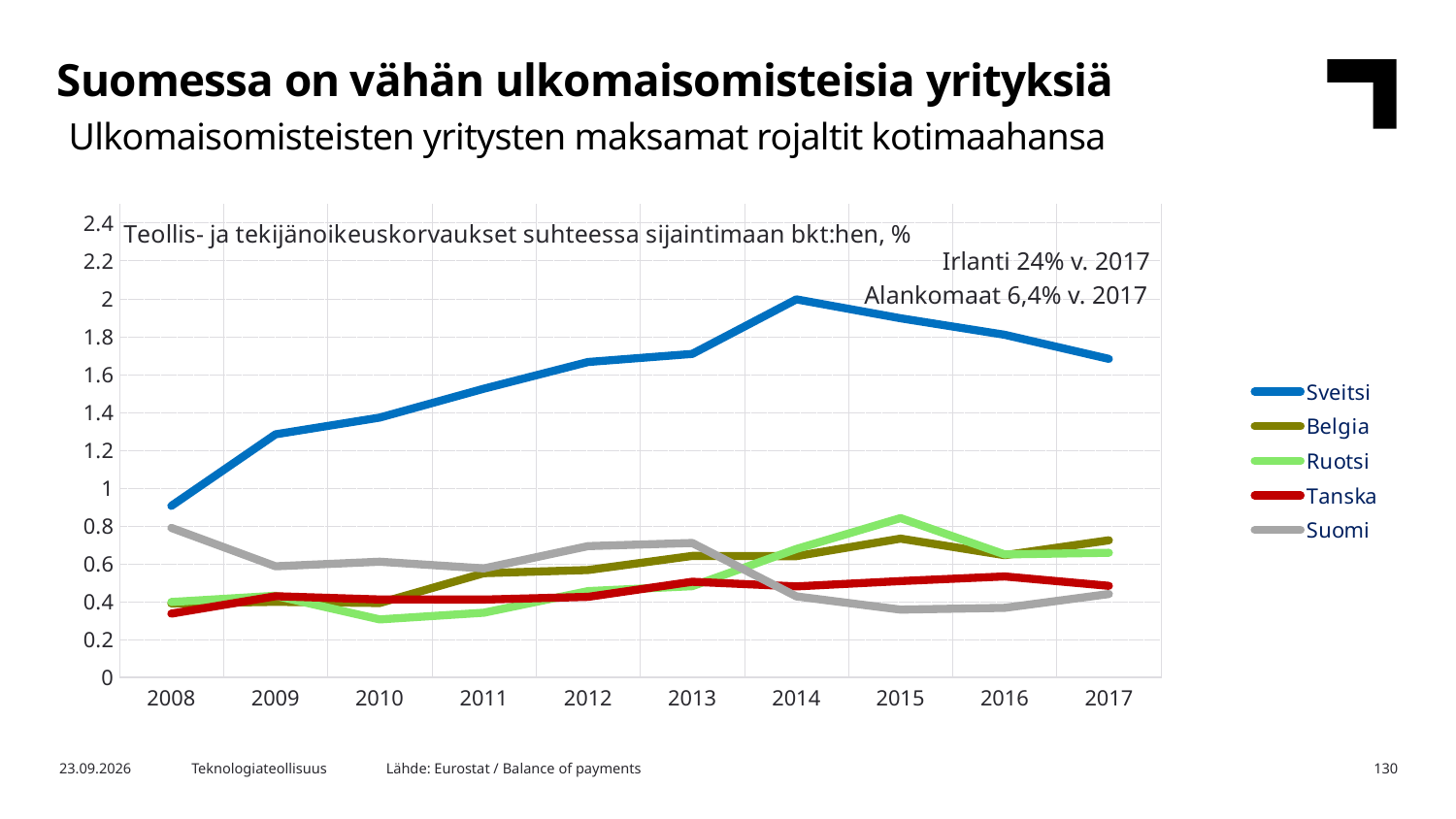
Is the value for Tanska in 2008 greater or less than 0.4? less What kind of chart is shown on the slide? line chart Which is larger in 2015, Ruotsi or Belgia? Ruotsi Is the value for Sveitsi in 2008 greater or less than 1? less How many series does the legend list? 5 In which year does the Sveitsi series reach its highest value? 2014 Is the value for Suomi in 2008 greater or less than 0.6? greater What is the title text shown inside the chart area? Teollis- ja tekijänoikeuskorvaukset suhteessa sijaintimaan bkt:hen, % Does the Sveitsi series rise or fall from 2008 to 2014? rise Which series has the highest value in 2017? Sveitsi How many years are shown on the x axis? 10